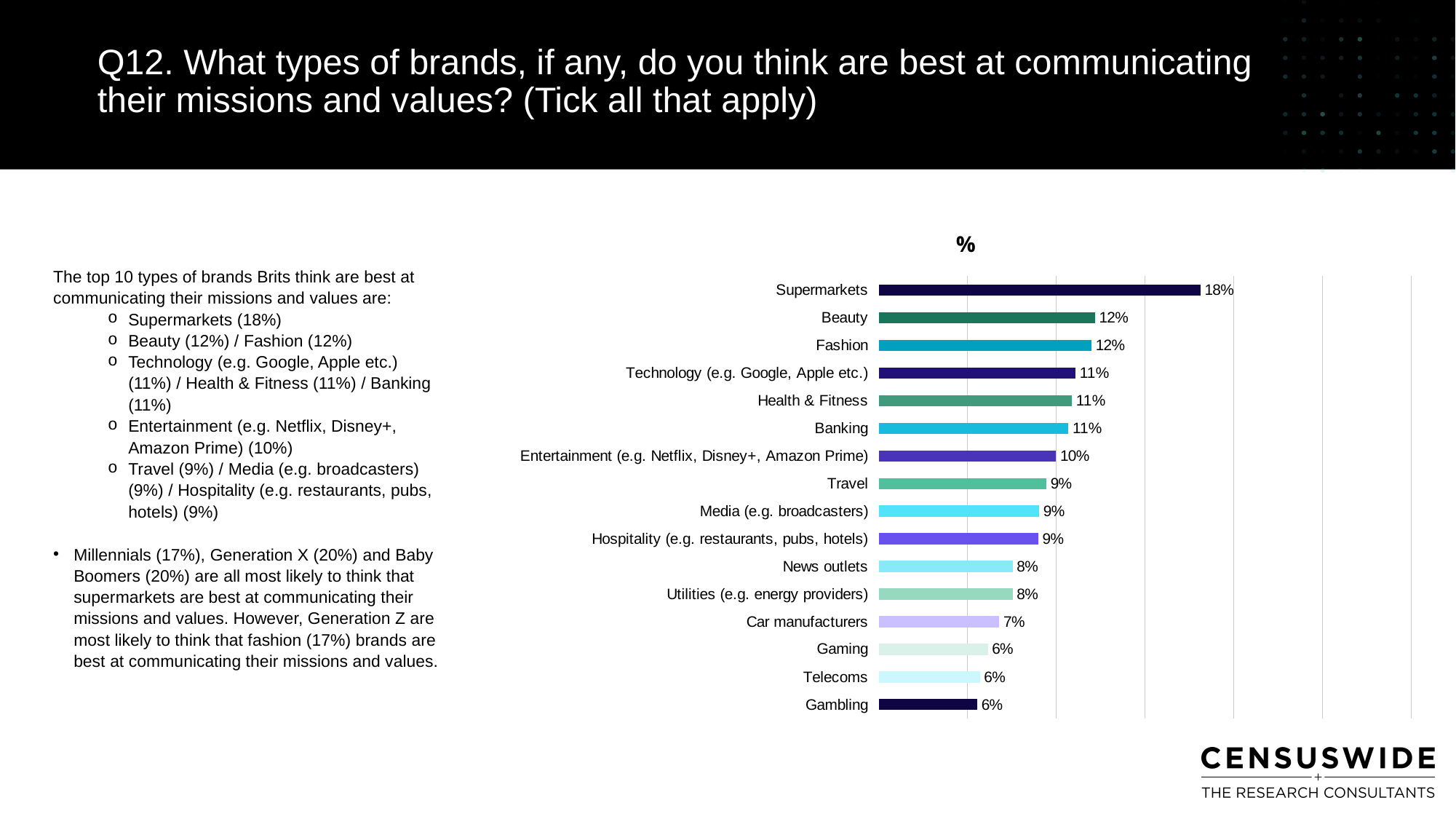
How many categories are shown in the chart? 16 Which is larger, the value for Fashion or the value for Hospitality (e.g. restaurants, pubs, hotels)? Fashion What is the value for News outlets? 8% Which category has the highest value? Supermarkets What is the difference between the values for Supermarkets and Beauty? 6% What is the value for Entertainment (e.g. Netflix, Disney+, Amazon Prime)? 10% What is the value for Supermarkets? 18% Which is larger, the value for Banking or the value for Telecoms? Banking What kind of chart is shown on the slide? Bar chart What is the title of the chart? % What is the value for Car manufacturers? 7% What is the difference between the values for Travel and Gaming? 3%